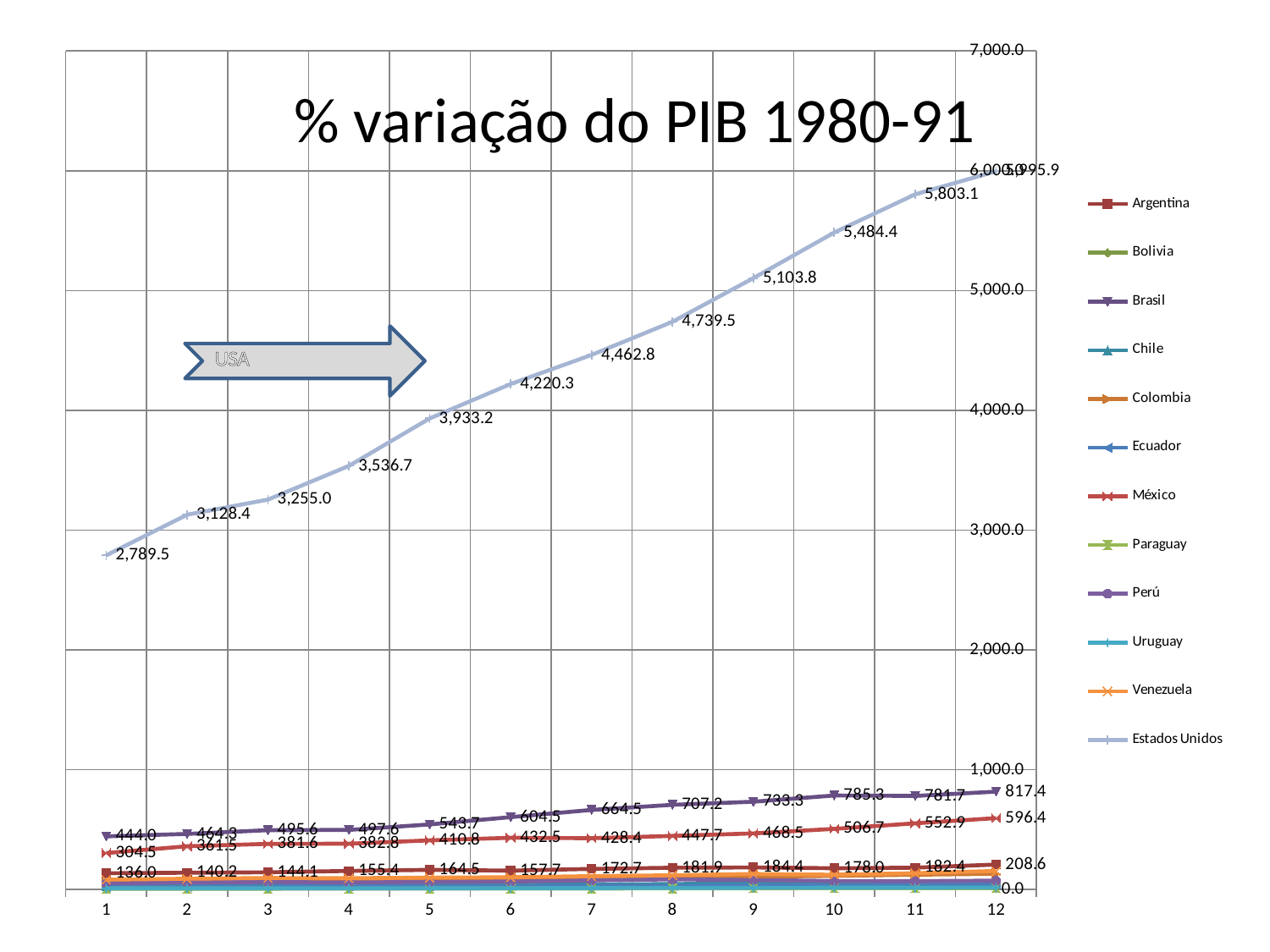
What is the value for Brasil at point 12? 817.4 How many series does the legend list? 12 At point 12, which is larger: Brasil or México? Brasil What is the difference between the Estados Unidos values at point 2 and point 1? 338.9 What is the value for Estados Unidos at point 1? 2,789.5 What is the value for Estados Unidos at point 11? 5,803.1 What is the value for México at point 12? 596.4 What is the title of the chart? % variação do PIB 1980-91 How many points are plotted along the x axis for each series? 12 What kind of chart is shown on the slide? line chart Which series has the highest value at point 12? Estados Unidos Does the Estados Unidos line rise or fall from point 1 to point 12? rise